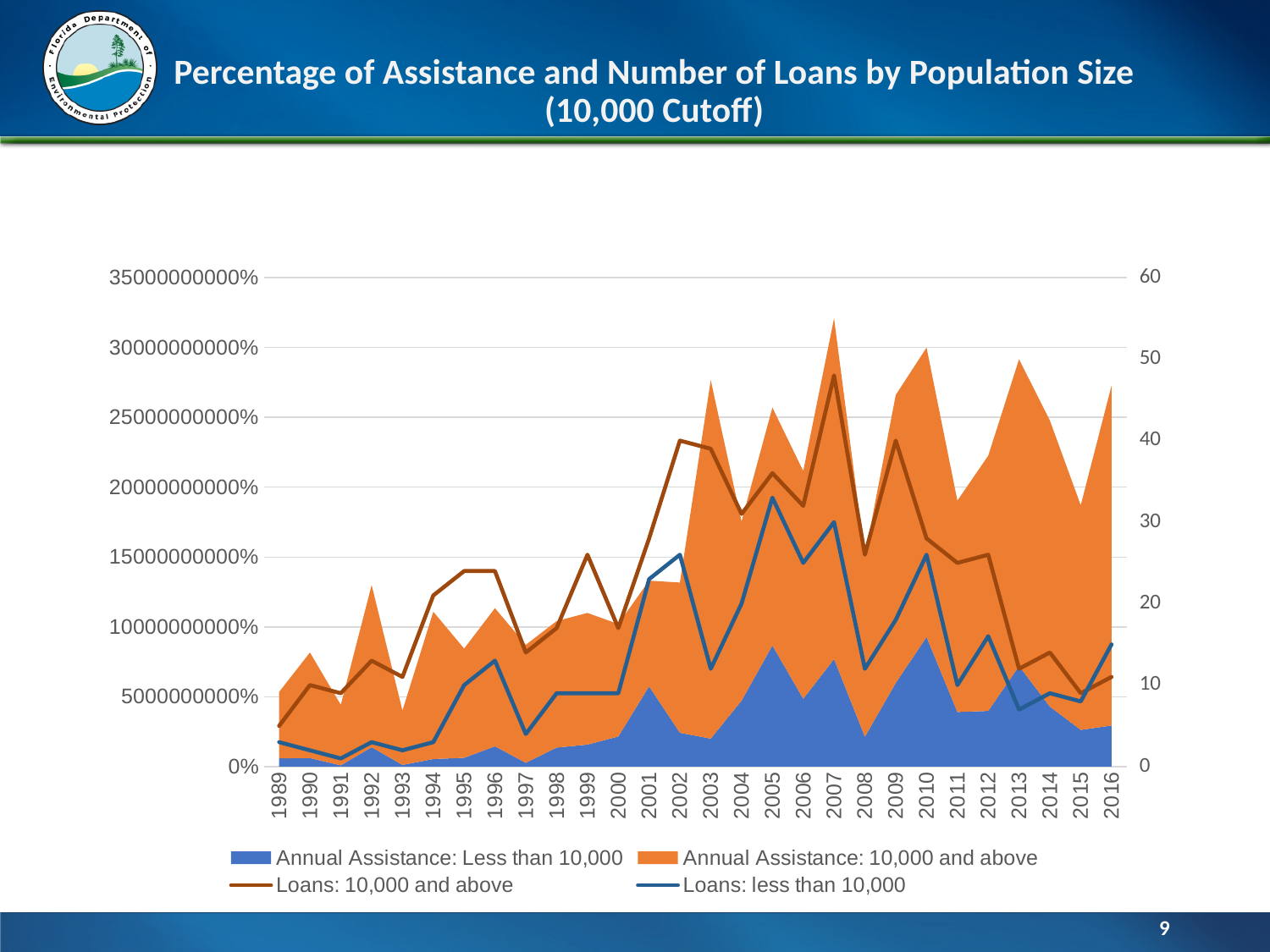
In which year does the 'Loans: 10,000 and above' line reach its highest value? 2007 What is the title of the chart? Percentage of Assistance and Number of Loans by Population Size (10,000 Cutoff) In 2002, which is larger: 'Loans: 10,000 and above' or 'Loans: less than 10,000'? Loans: 10,000 and above Is the value of 'Loans: less than 10,000' in 1997 greater or less than 10? less Is the value of 'Loans: 10,000 and above' in 2013 greater or less than 20? less How many years are shown along the x axis? 28 Which colour represents the 'Annual Assistance: 10,000 and above' series? Orange How many series does the legend list? 4 Is the value of 'Loans: 10,000 and above' in 2007 greater or less than 40? greater What kind of chart is shown on the slide? A combination area and line chart Does the 'Loans: 10,000 and above' line rise or fall from 1989 to 2002? Rise In which year is the 'Loans: 10,000 and above' line at its lowest value? 1989